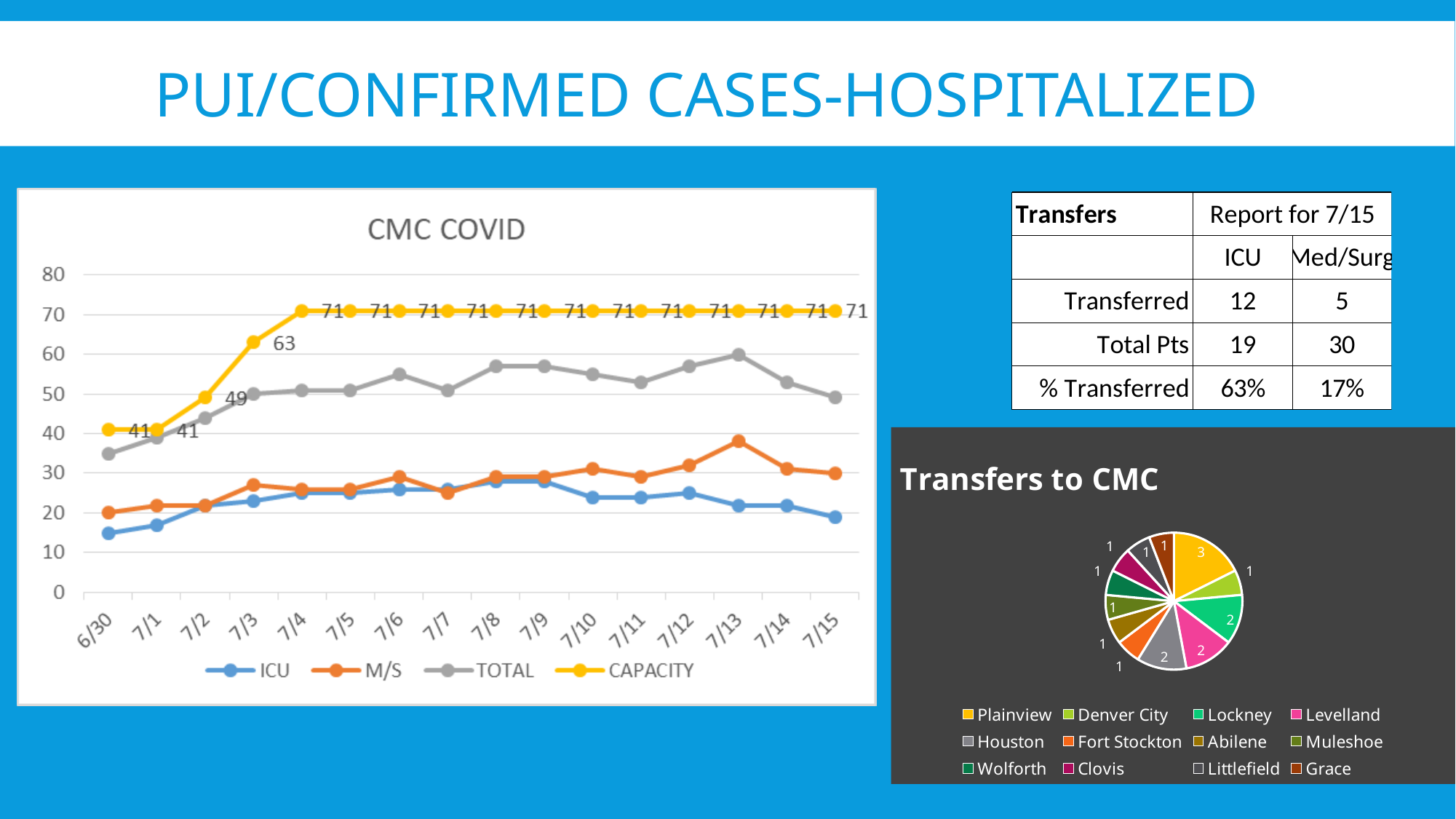
In the CMC COVID chart, by how much does CAPACITY increase from 7/3 to 7/4? 8 In the CMC COVID chart, what is the CAPACITY value on 7/15? 71 How many locations does the legend of the Transfers to CMC chart list? 12 In the CMC COVID chart, on 7/13 which is larger, M/S or ICU? M/S How many dates are shown on the x axis of the CMC COVID chart? 16 What kind of chart is the Transfers to CMC chart? pie chart In the CMC COVID chart, what is the CAPACITY value on 7/2? 49 What kind of chart is the CMC COVID chart? line chart In the CMC COVID chart, is the TOTAL value on 7/13 greater or less than 50? greater In the CMC COVID chart, what is the CAPACITY value on 7/3? 63 How many series does the legend of the CMC COVID chart list? 4 In the Transfers to CMC chart, which location has the largest slice? Plainview